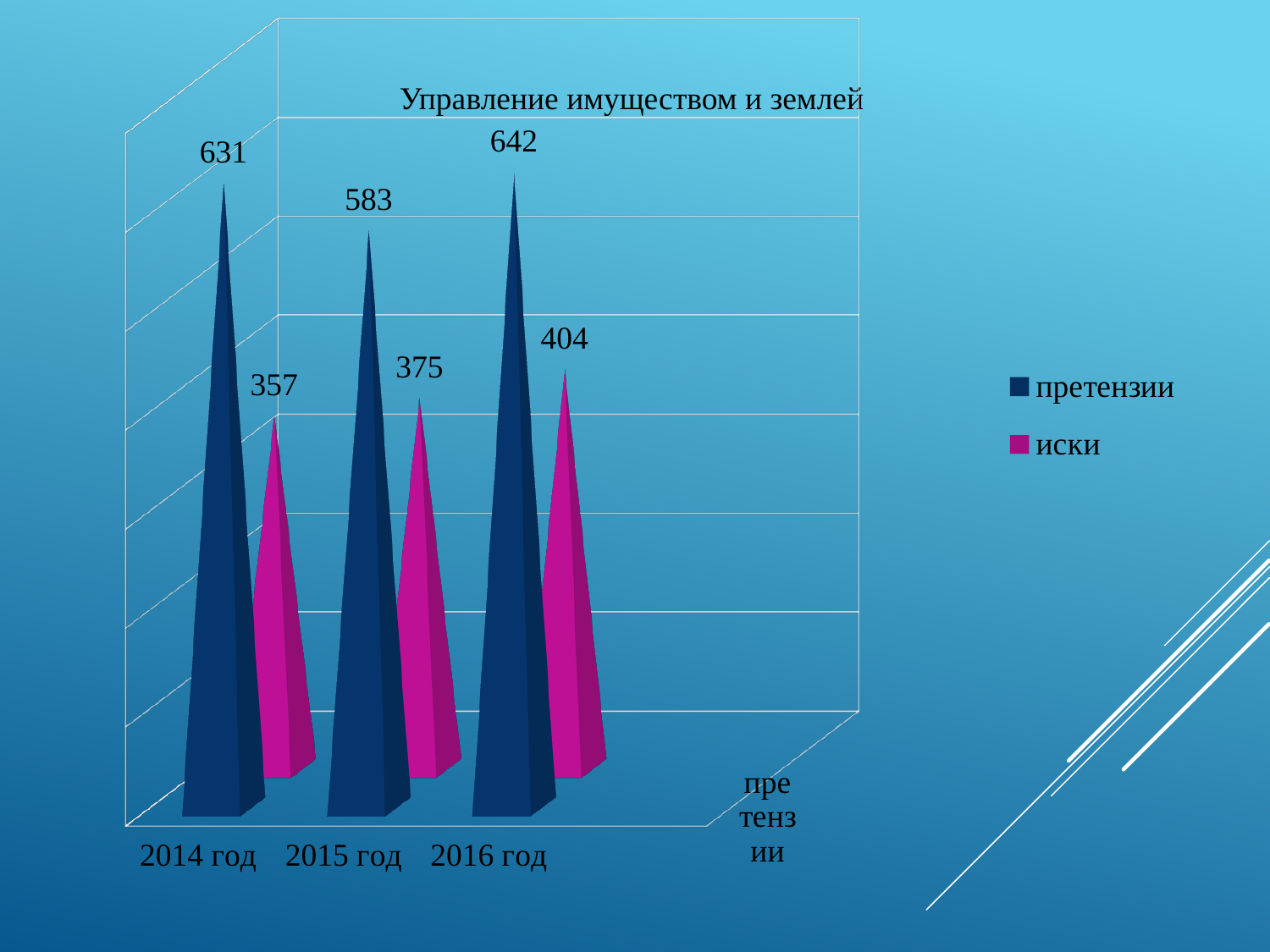
What is the value for претензии in 2015 год? 583 In which year is the value for иски the lowest? 2014 год How many series does the legend list? 2 How many years are shown on the x axis? 3 Do the values for иски rise or fall from 2014 год to 2016 год? rise Which is larger in 2015 год, претензии or иски? претензии What is the value for претензии in 2014 год? 631 What is the difference between претензии and иски in 2016 год? 238 In which year is the value for претензии the highest? 2016 год What is the value for иски in 2016 год? 404 What is the title of the chart? Управление имуществом и землей What is the difference between претензии in 2014 год and 2015 год? 48